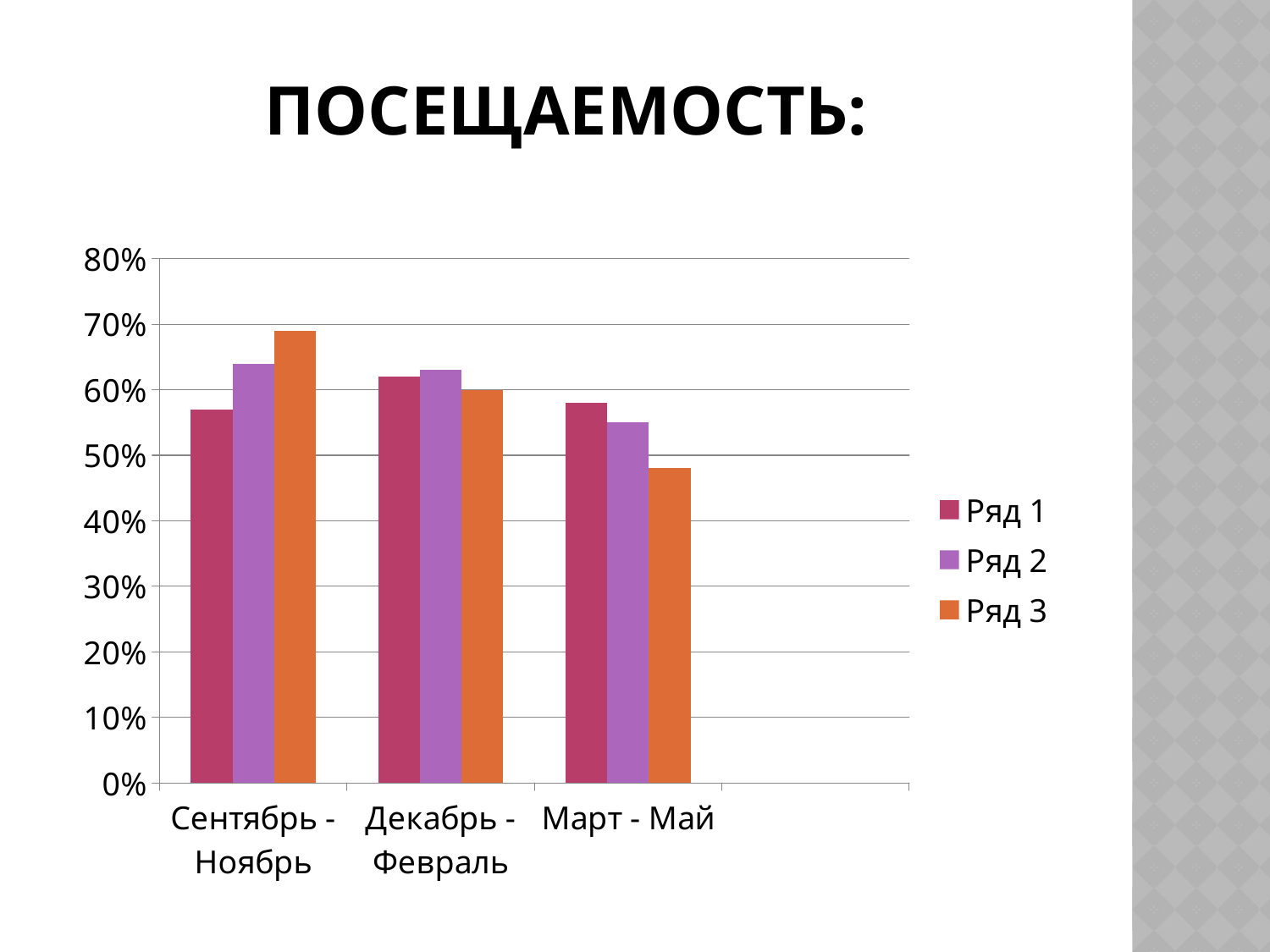
Is the value for Ряд 3 in Март - Май greater or less than 50%? less Which is larger: Ряд 3 in Сентябрь - Ноябрь or Ряд 3 in Март - Май? Ряд 3 in Сентябрь - Ноябрь What kind of chart is shown on the slide? Bar chart Which series is shown in orange in the legend? Ряд 3 What is the title of the chart? ПОСЕЩАЕМОСТЬ: Do the values for Ряд 3 rise or fall from Сентябрь - Ноябрь to Март - Май? fall Which series has the highest bar in Сентябрь - Ноябрь? Ряд 3 How many categories are shown on the x axis? 3 Is the value for Ряд 3 in Сентябрь - Ноябрь greater or less than 60%? greater Is the value for Ряд 1 in Сентябрь - Ноябрь greater or less than 60%? less How many series does the legend list? 3 Which series has the lowest bar in Март - Май? Ряд 3